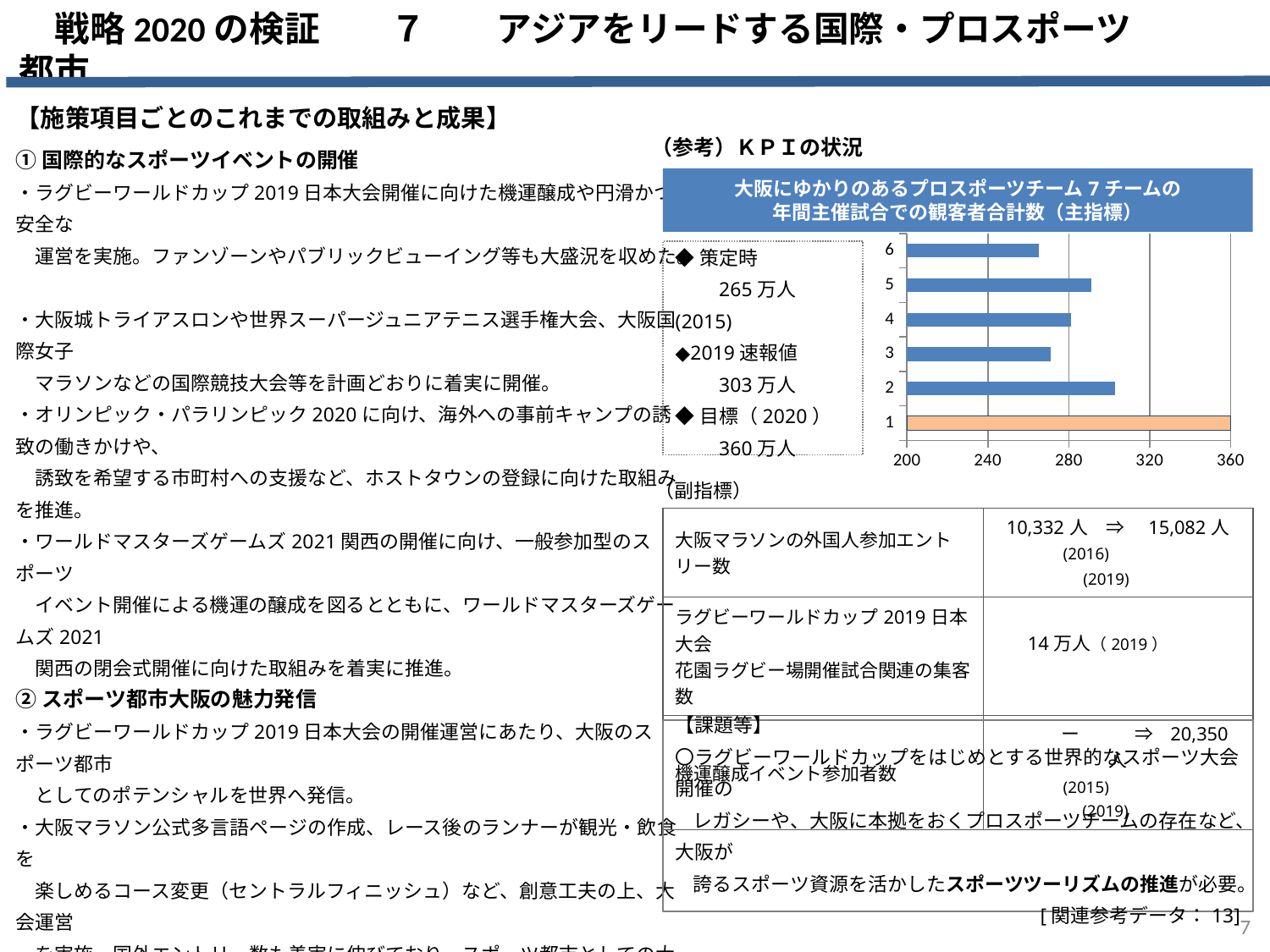
Which category has the longest bar in the chart? 1 Is the value for category 6 greater or less than 280? less Is the value for category 2 greater or less than 280? greater What is the highest tick value shown on the x axis of the chart? 360 Which is larger, the value for category 1 or the value for category 2? category 1 What colour is the bar for category 1, which differs from the other bars? orange Is the value for category 3 greater or less than 280? less What kind of chart is shown on the slide? bar chart Which is larger, the value for category 2 or the value for category 5? category 2 How many categories are plotted on the y axis of the bar chart? 6